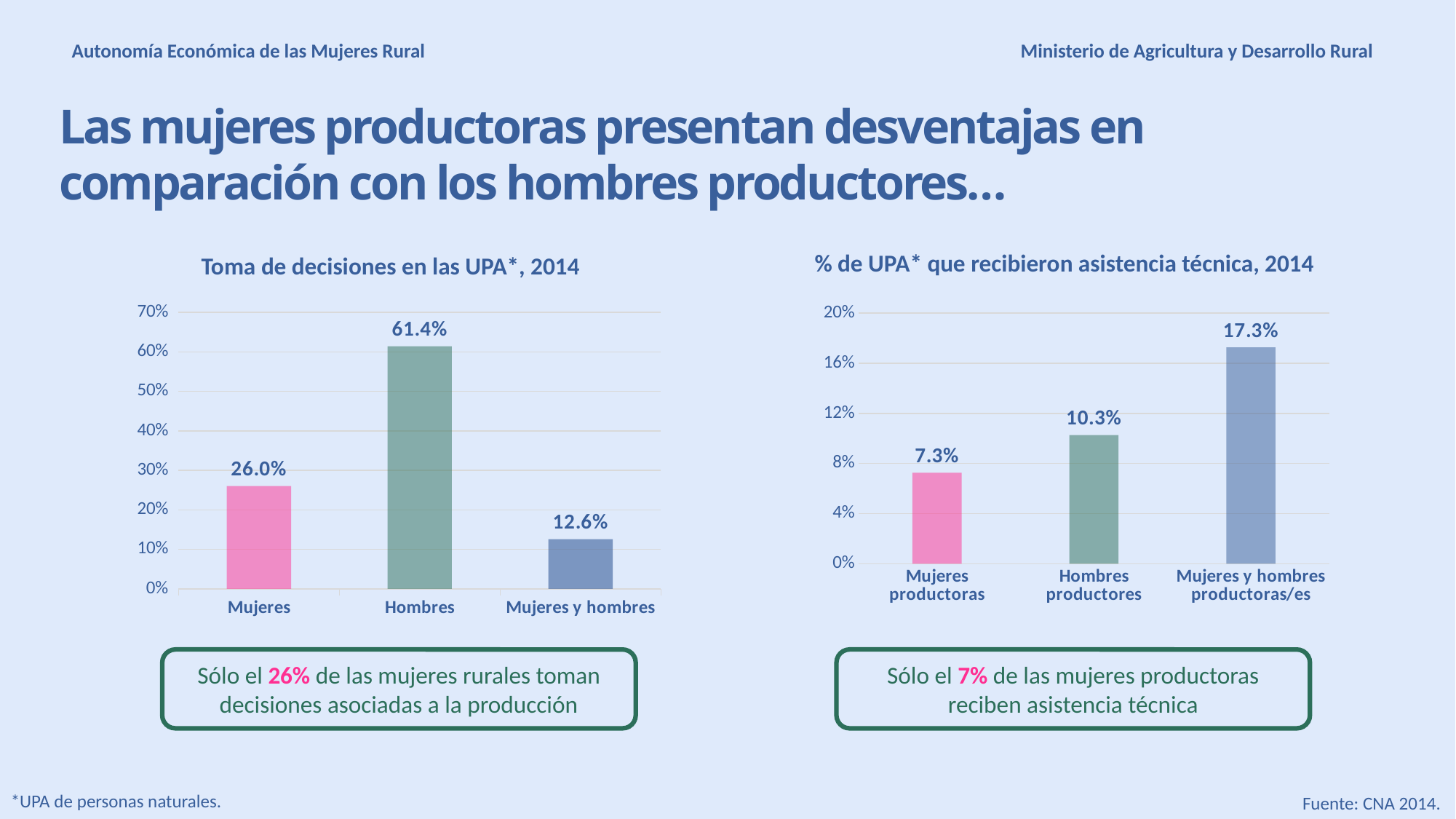
In the chart '% de UPA* que recibieron asistencia técnica, 2014', which category has the highest value? Mujeres y hombres productoras/es In the chart 'Toma de decisiones en las UPA*, 2014', which category has the lowest value? Mujeres y hombres What kind of chart is the chart on the left of the slide? Bar chart In the chart '% de UPA* que recibieron asistencia técnica, 2014', what is the difference between the values for Mujeres y hombres productoras/es and Hombres productores? 7.0% In the chart '% de UPA* que recibieron asistencia técnica, 2014', what is the value for Mujeres productoras? 7.3% In the chart 'Toma de decisiones en las UPA*, 2014', how many categories are shown? 3 In the chart '% de UPA* que recibieron asistencia técnica, 2014', do the values rise or fall from left to right? Rise In the chart '% de UPA* que recibieron asistencia técnica, 2014', what is the value for Hombres productores? 10.3% In the chart '% de UPA* que recibieron asistencia técnica, 2014', which is larger: the value for Hombres productores or Mujeres productoras? Hombres productores In the chart 'Toma de decisiones en las UPA*, 2014', what is the value for Hombres? 61.4% In the chart 'Toma de decisiones en las UPA*, 2014', what is the value for Mujeres y hombres? 12.6% In the chart 'Toma de decisiones en las UPA*, 2014', what is the difference between the values for Hombres and Mujeres? 35.4%